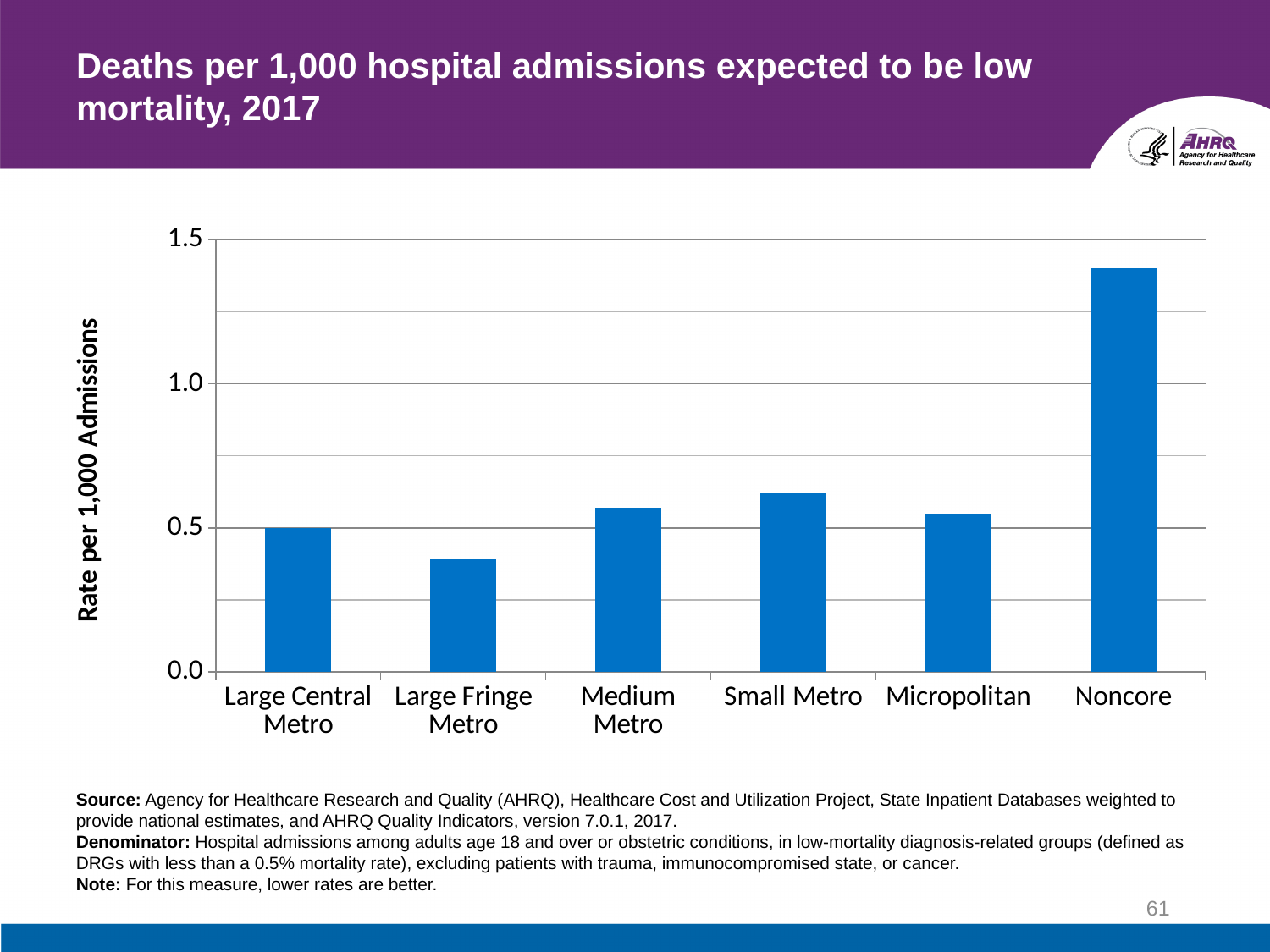
Which is larger, the value for Noncore or the value for Large Fringe Metro? Noncore Is the value for Large Fringe Metro greater or less than 0.5? less Is the value for Small Metro greater or less than 0.5? greater What is the label of the y axis of the chart? Rate per 1,000 Admissions Is the value for Noncore greater or less than 1.0? greater Which is larger, the value for Small Metro or the value for Large Fringe Metro? Small Metro How many categories are shown on the x axis of the chart? 6 Which category has the lowest rate per 1,000 admissions? Large Fringe Metro What kind of chart is shown on the slide? bar chart Which category has the highest rate per 1,000 admissions? Noncore What is the title of the slide? Deaths per 1,000 hospital admissions expected to be low mortality, 2017